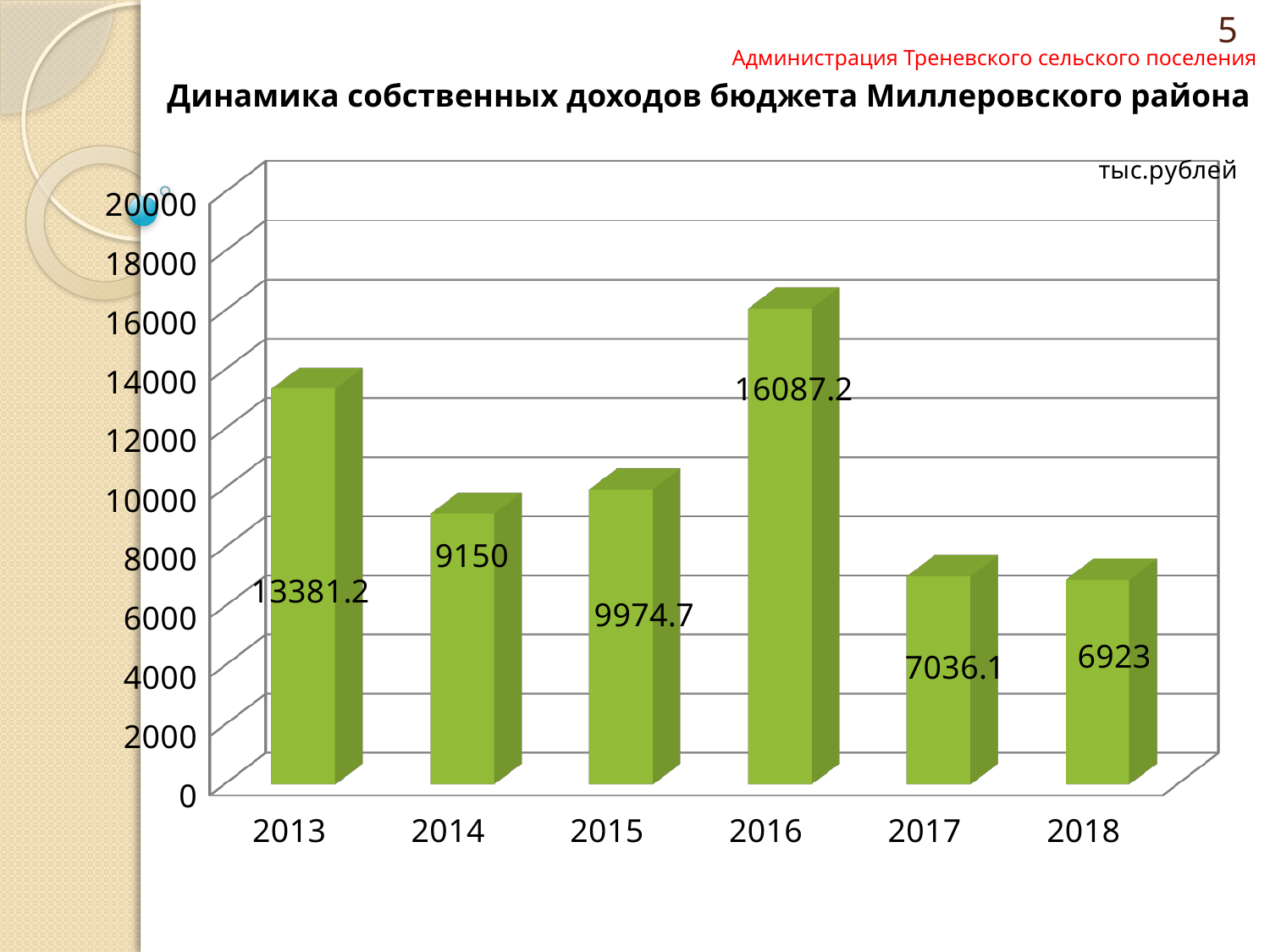
How many years are shown on the x axis? 6 What kind of chart is shown on the slide? bar chart What is the value for 2014? 9150 What is the value for 2016? 16087.2 Do the values rise or fall from 2016 to 2018? fall Is the value for 2013 greater or less than 12000? greater What is the value for 2018? 6923 What is the difference between the values for 2015 and 2014? 824.7 Which year has the highest value? 2016 Which year has the lowest value? 2018 Which is larger, the value for 2017 or the value for 2018? 2017 What is the difference between the values for 2016 and 2013? 2706